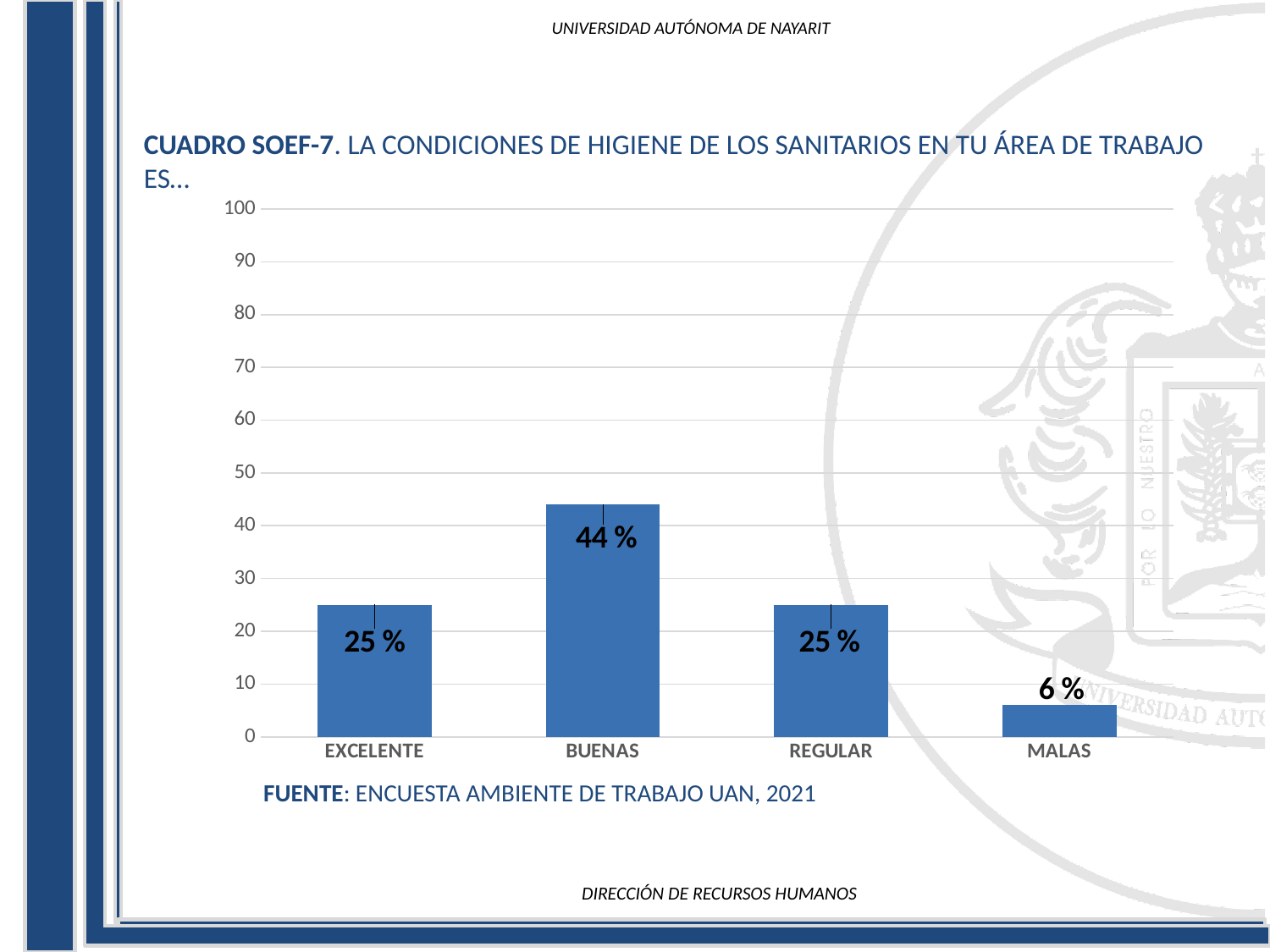
Which category has the highest value? BUENAS How many categories are shown on the x axis? 4 Which is larger, the value for BUENAS or the value for MALAS? BUENAS Which category has the lowest value? MALAS What source is cited below the chart? ENCUESTA AMBIENTE DE TRABAJO UAN, 2021 What is the difference between the values for BUENAS and REGULAR? 19 % What is the value for BUENAS? 44 % What is the value for MALAS? 6 % Is the value for MALAS greater or less than 10? less What is the value for EXCELENTE? 25 % Is the value for BUENAS greater or less than 40? greater What kind of chart is shown on the slide? bar chart